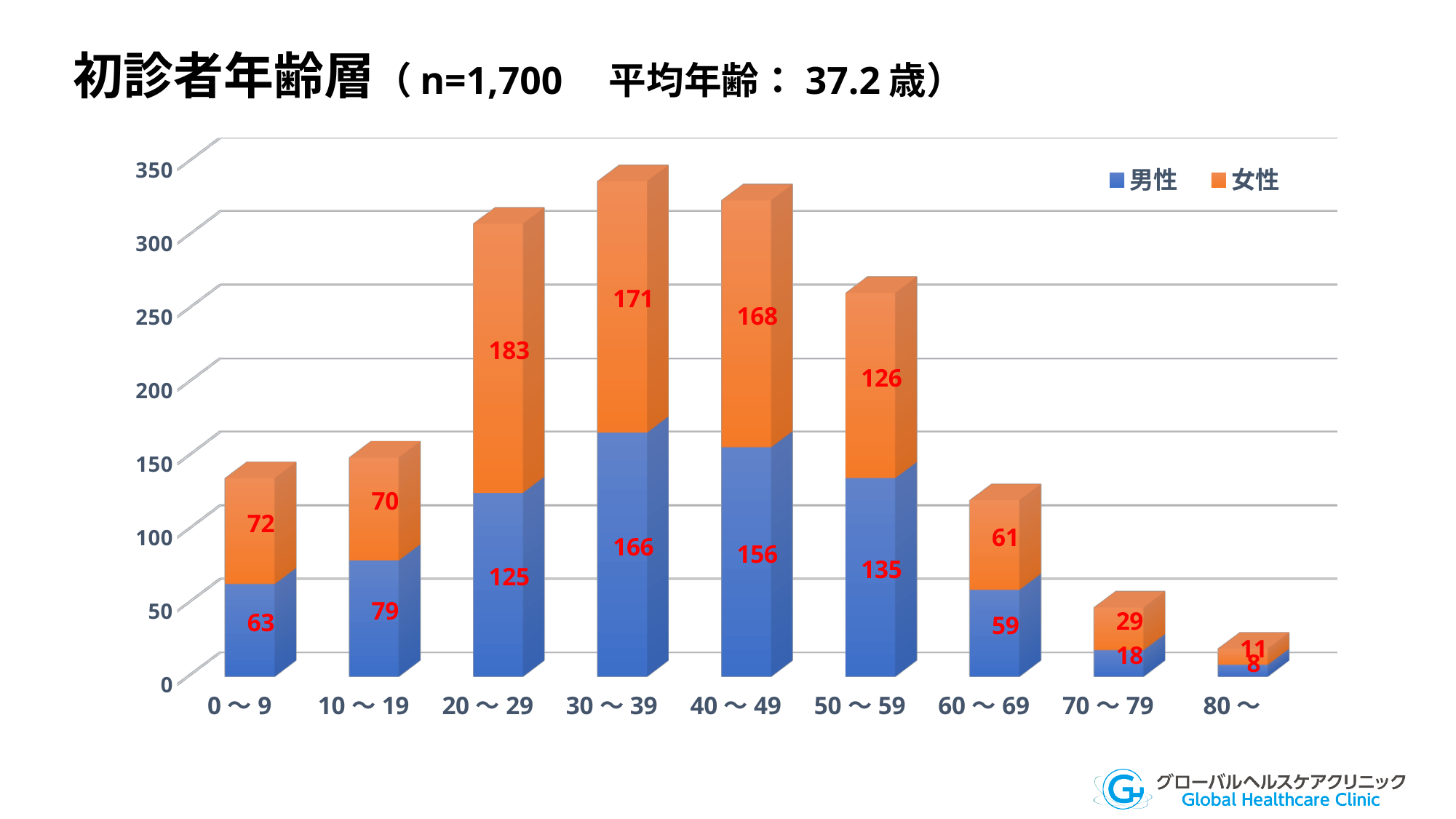
What is the total of the stacked bar for the 30～39 age group? 337 Is the total of the stacked bar for 50～59 greater or less than 250? greater What is the difference between the 女性 and 男性 values in the 40～49 age group? 12 Which age group has the lowest 男性 value? 80～ Which is larger, the 男性 value for 10～19 or the 男性 value for 0～9? 10～19 How many series does the legend list? 2 What is the 女性 value for the 20～29 age group? 183 What type of chart is shown on the slide? stacked bar chart Which age group has the highest 女性 value? 20～29 How many age-group categories are shown on the x axis? 9 What is the sample size (n) stated in the chart title? 1,700 What is the 男性 value for the 30～39 age group? 166